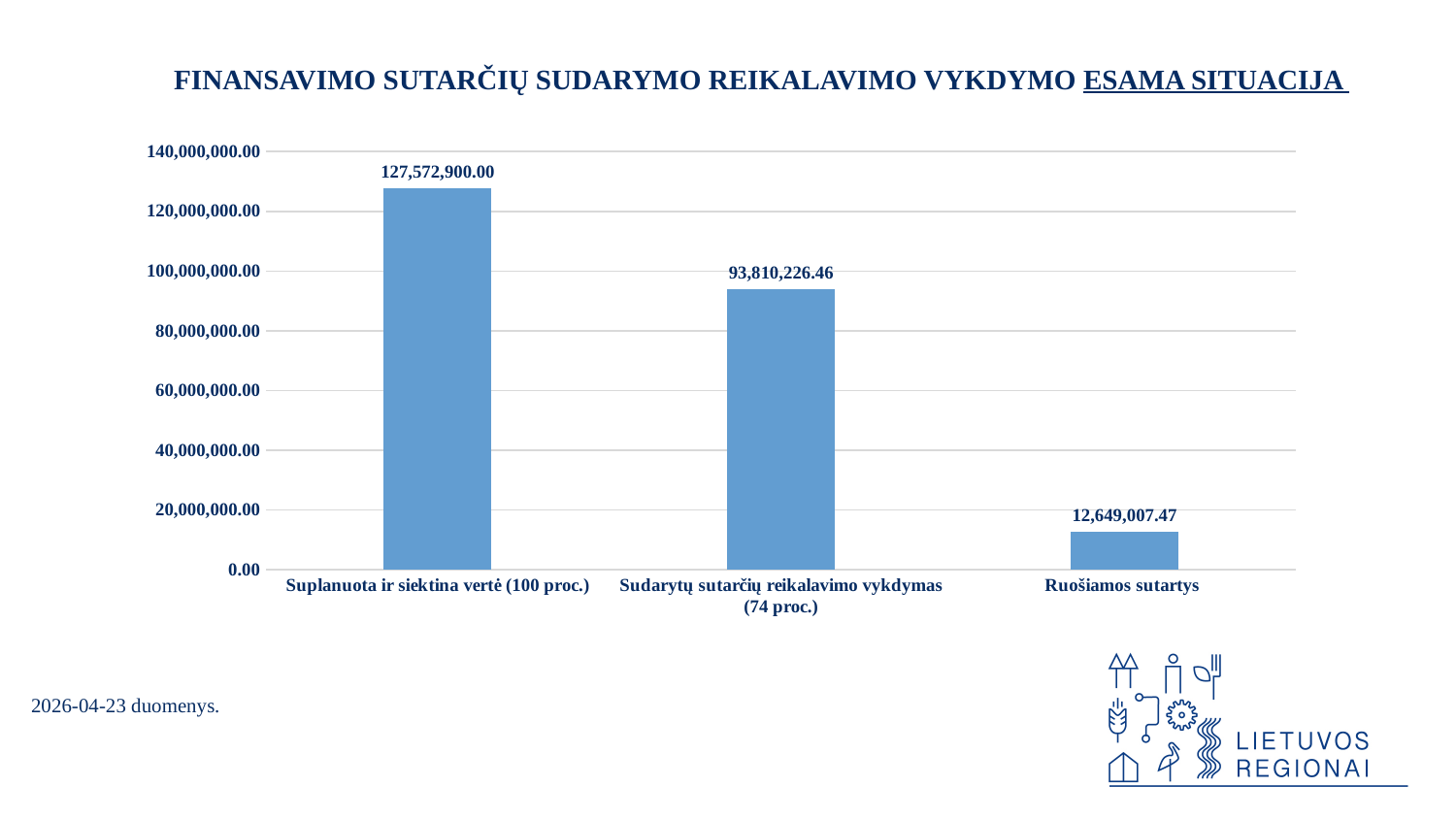
What kind of chart is shown on the slide? bar chart What is the value for Sudarytų sutarčių reikalavimo vykdymas (74 proc.)? 93,810,226.46 What is the value for Ruošiamos sutartys? 12,649,007.47 What is the value for Suplanuota ir siektina vertė (100 proc.)? 127,572,900.00 Do the values rise or fall from left to right across the categories? fall Which category has the lowest value? Ruošiamos sutartys What is the difference between the values for Sudarytų sutarčių reikalavimo vykdymas (74 proc.) and Ruošiamos sutartys? 81,161,218.99 Which is larger: the value for Sudarytų sutarčių reikalavimo vykdymas (74 proc.) or the value for Ruošiamos sutartys? Sudarytų sutarčių reikalavimo vykdymas (74 proc.) Is the value for Ruošiamos sutartys greater or less than 20,000,000.00? less What is the difference between the values for Suplanuota ir siektina vertė (100 proc.) and Sudarytų sutarčių reikalavimo vykdymas (74 proc.)? 33,762,673.54 Which category has the highest value? Suplanuota ir siektina vertė (100 proc.) How many categories are shown in the chart? 3